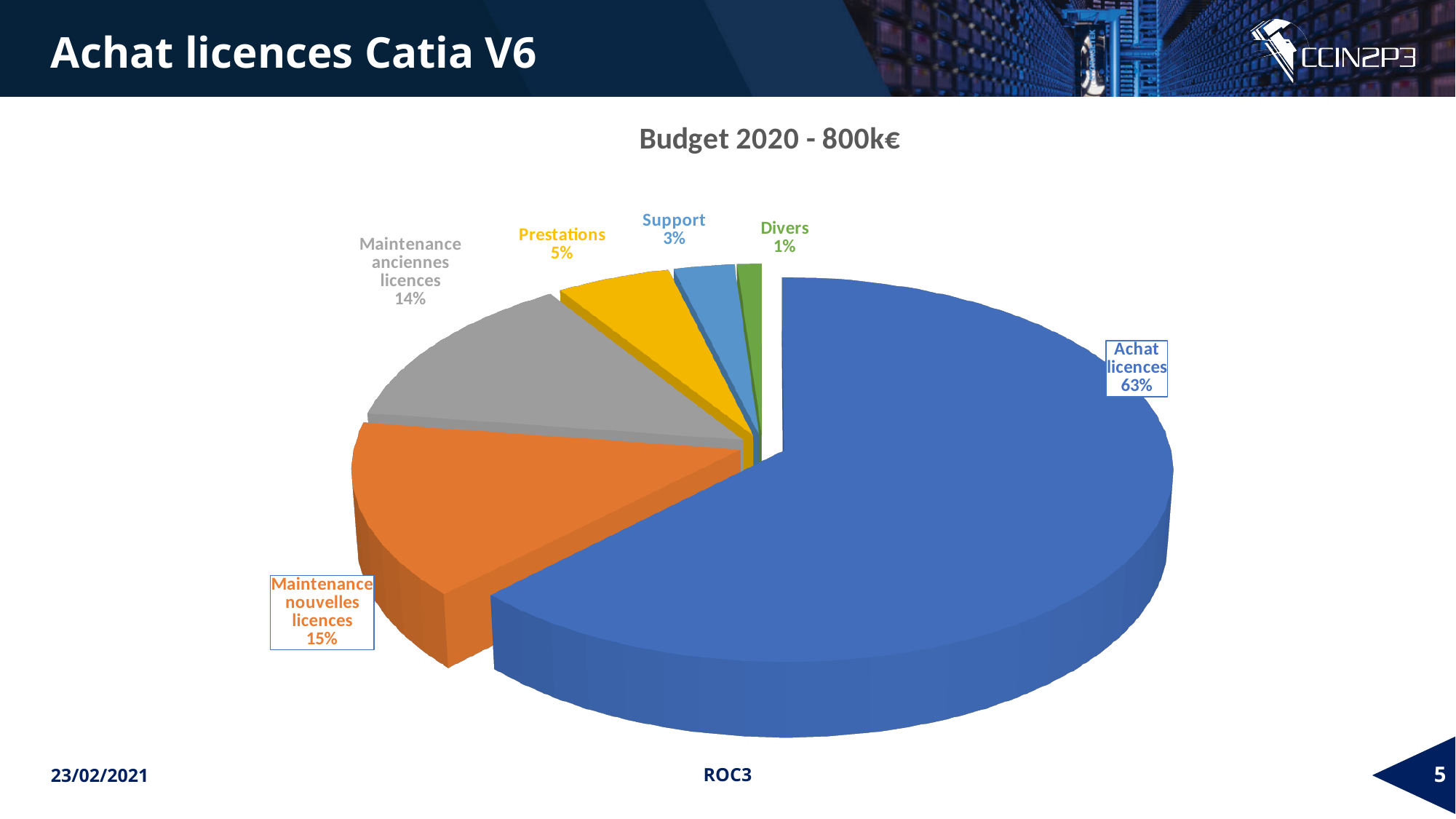
What is the difference in percentage points between Achat licences and Maintenance nouvelles licences? 48 What percentage is shown for Maintenance anciennes licences? 14% Which category has the largest share of the pie? Achat licences What kind of chart is shown on the slide? Pie chart Which is larger, the share for Prestations or the share for Support? Prestations What percentage is shown for Support? 3% What percentage is shown for Maintenance nouvelles licences? 15% How many categories are shown in the pie chart? 6 What percentage is shown for Prestations? 5% What share of the budget goes to Achat licences? 63% Which category has the smallest share of the pie? Divers What is the title of the chart? Budget 2020 - 800k€